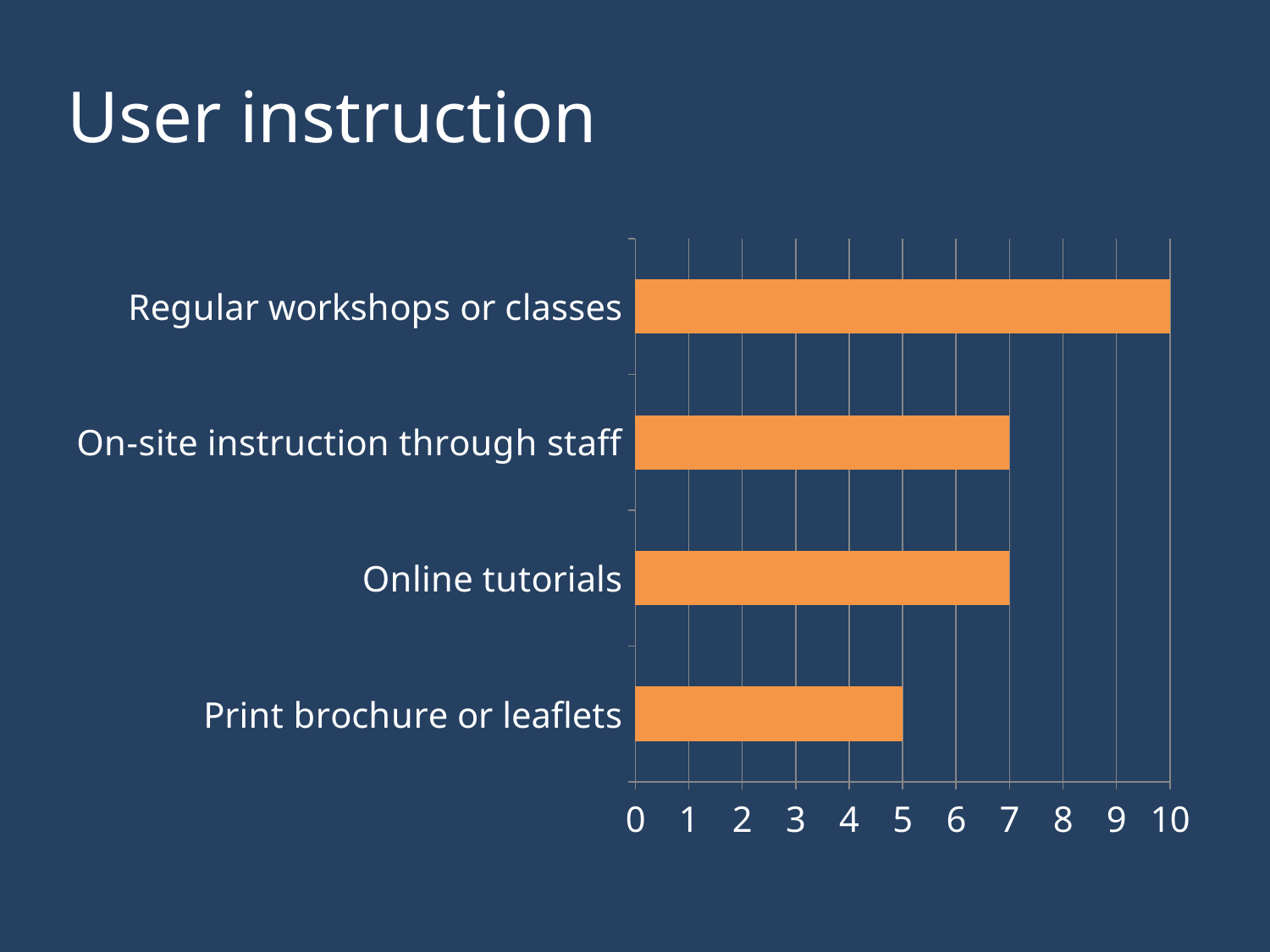
Which category has the lowest value? Print brochure or leaflets What is the value for Online tutorials? 7 Which category has the highest value? Regular workshops or classes What is the difference between the values for Online tutorials and Print brochure or leaflets? 2 What kind of chart is shown on the slide? bar chart How many categories are shown in the chart? 4 What is the value for On-site instruction through staff? 7 Is the value for Print brochure or leaflets greater or less than 6? less What is the difference between the values for Regular workshops or classes and Print brochure or leaflets? 5 What is the value for Print brochure or leaflets? 5 Which is larger, the value for Regular workshops or classes or the value for Online tutorials? Regular workshops or classes What is the value for Regular workshops or classes? 10